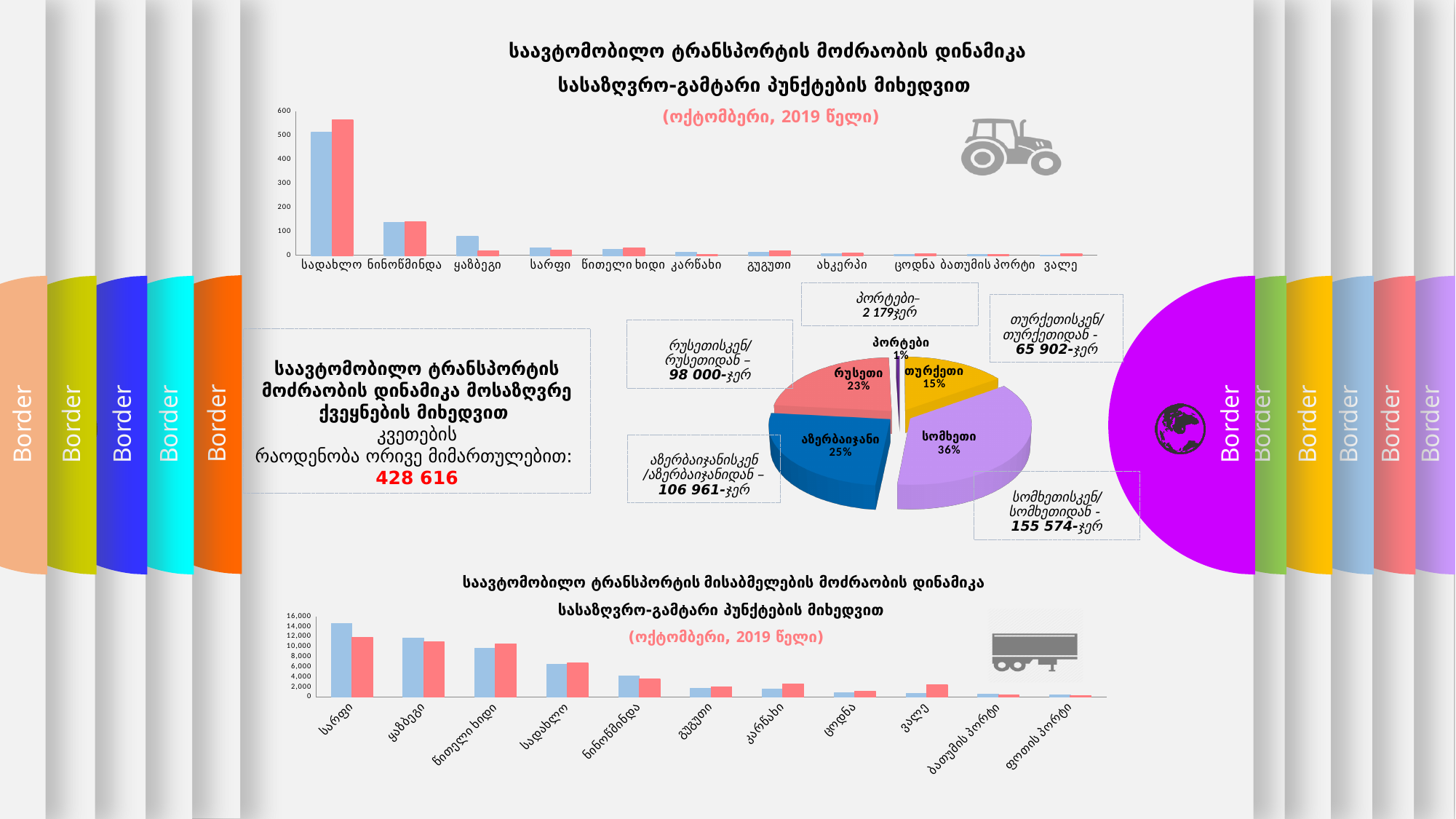
In the top bar chart, is the value for ნინოწმინდა greater or less than 100? greater In the pie chart in the middle of the slide, what share does რუსეთი have? 23% In the pie chart in the middle of the slide, which has the larger share, აზერბაიჯანი or თურქეთი? აზერბაიჯანი What kind of chart is the bottom chart on the slide? bar chart In the pie chart in the middle of the slide, which country has the largest share? სომხეთი In the pie chart in the middle of the slide, how many percentage points larger is the share of სომხეთი than the share of რუსეთი? 13 In the pie chart in the middle of the slide, what share does სომხეთი have? 36% In the pie chart in the middle of the slide, which slice is the smallest? პორტები In the bottom bar chart, is the value for ნინოწმინდა greater or less than 6,000? less In the top bar chart, which category has the highest bars? სადახლო In the top bar chart, how many categories are shown on the x axis? 11 In the pie chart in the middle of the slide, how many slices are there? 5